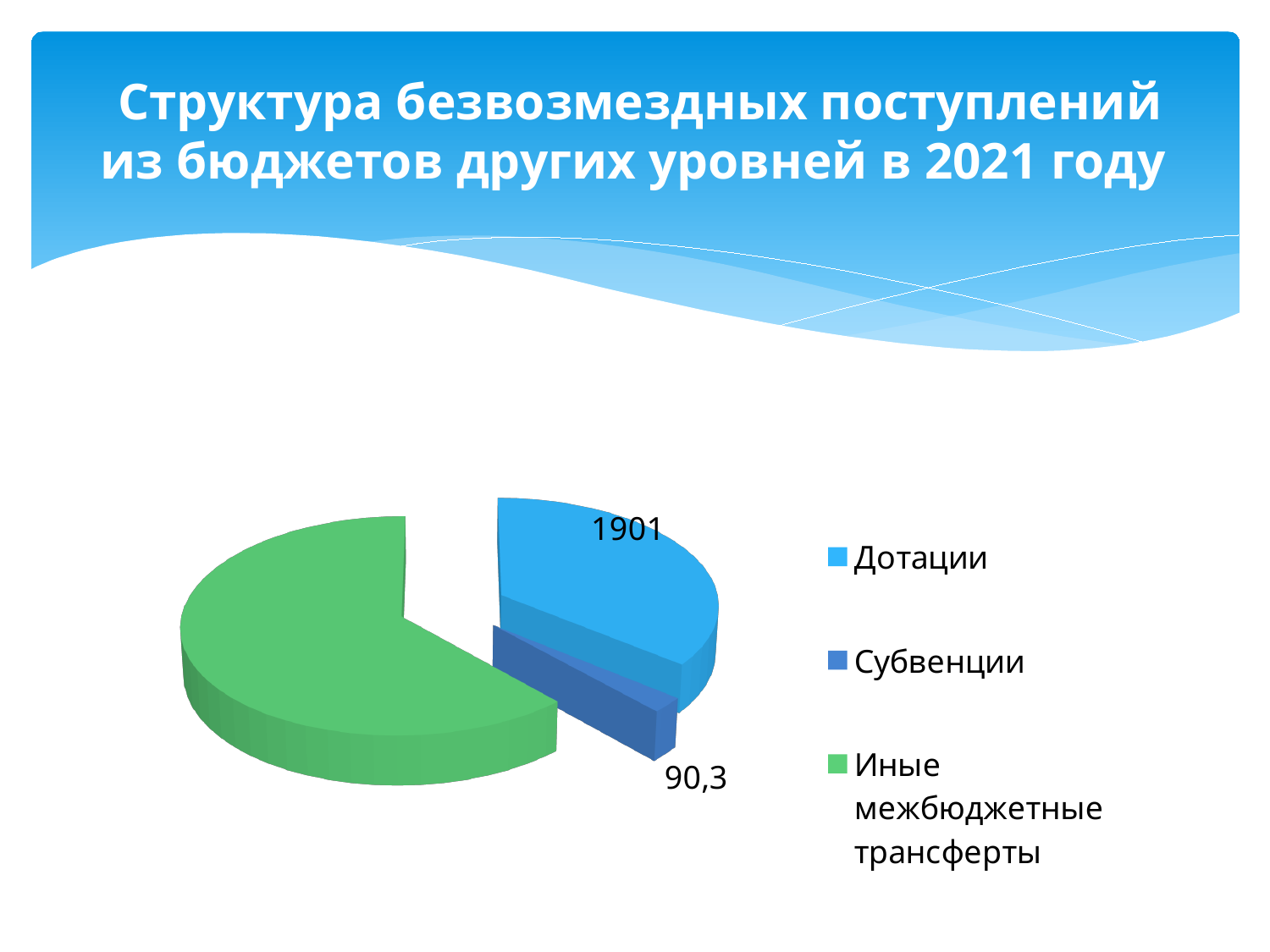
What kind of chart is shown on the slide? Pie chart Which is larger, the value for Дотации or the value for Субвенции? Дотации Which colour represents Иные межбюджетные трансферты in the pie chart? Green Which category has the largest slice of the pie chart? Иные межбюджетные трансферты What is the difference between the value for Дотации and the value for Субвенции? 1810,7 What value is shown for Субвенции on the pie chart? 90,3 Which category has the smallest slice of the pie chart? Субвенции What is the title of the slide? Структура безвозмездных поступлений из бюджетов других уровней в 2021 году How many categories are shown in the pie chart? 3 What value is shown for Дотации on the pie chart? 1901